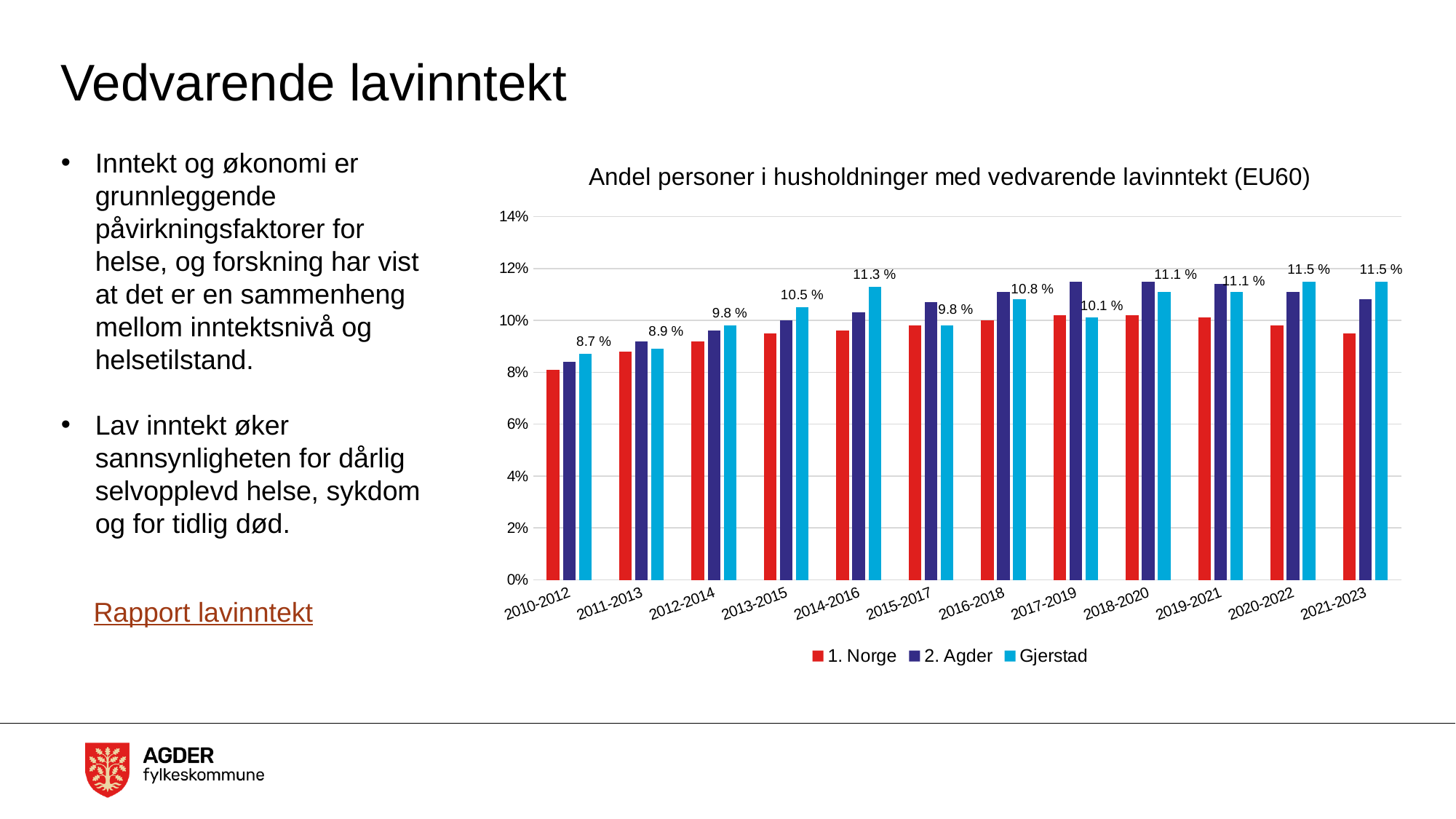
What is the value for Gjerstad in 2017-2019? 10.1 % What kind of chart is shown on the slide? Bar chart In which period is the Gjerstad value lowest? 2010-2012 Which is larger for Gjerstad: the value for 2014-2016 or the value for 2015-2017? 2014-2016 What is the highest value shown for Gjerstad? 11.5 % What is the difference between the Gjerstad values for 2014-2016 and 2015-2017? 1.5 percentage points What is the value for Gjerstad in 2010-2012? 8.7 % How many series does the legend list? 3 What is the value for Gjerstad in 2014-2016? 11.3 % How many periods are shown on the x axis? 12 Is the value for 2. Agder in 2017-2019 greater or less than 10%? greater Is the value for 1. Norge in 2010-2012 greater or less than 10%? less